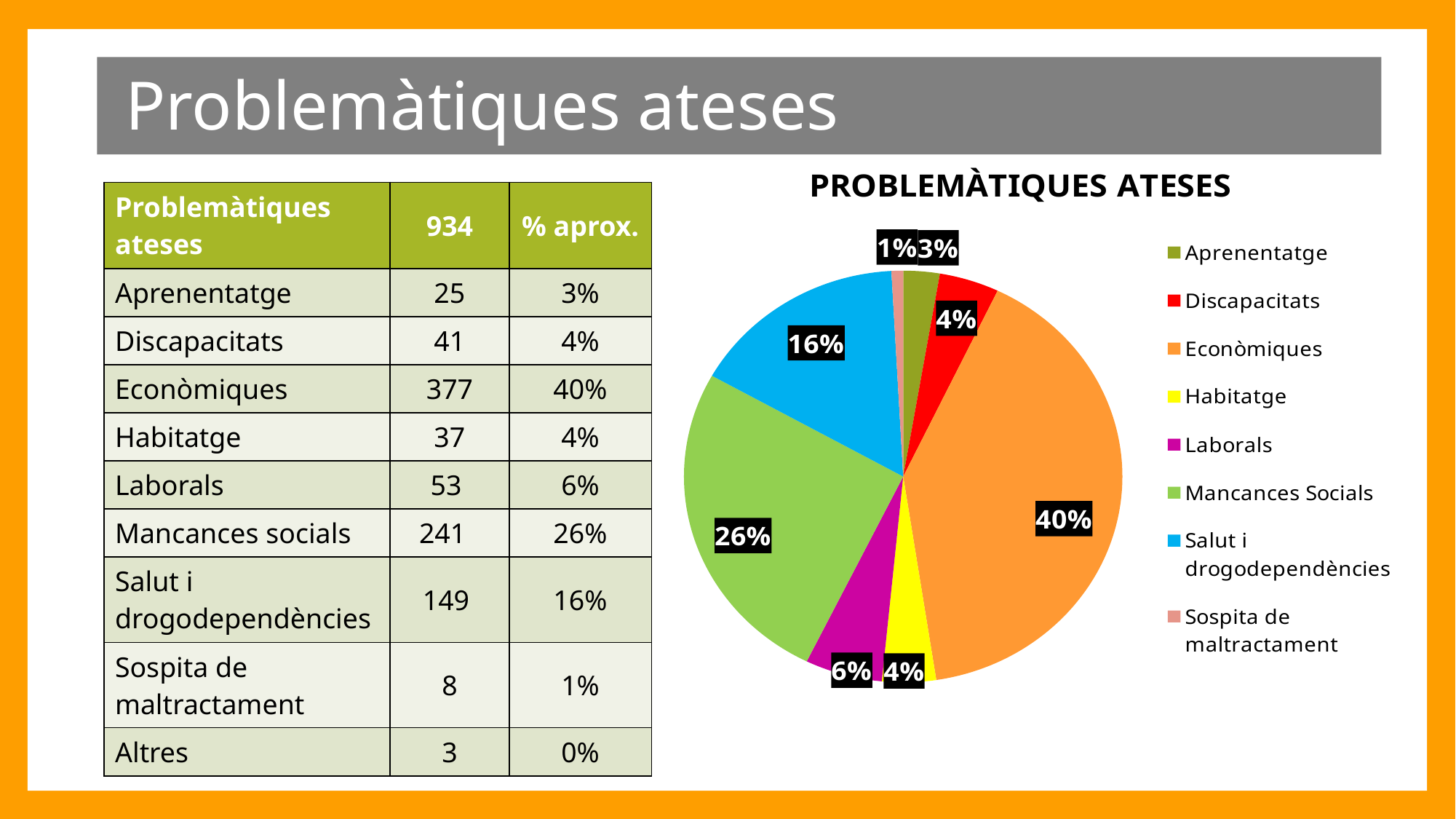
Which category has the smallest slice of the pie? Sospita de maltractament What is the difference in percentage points between the Econòmiques slice and the Mancances Socials slice? 14 What share of the pie does Mancances Socials represent? 26% Which slice is larger, Salut i drogodependències or Laborals? Salut i drogodependències What share of the pie does Aprenentatge represent? 3% What share of the pie does Salut i drogodependències represent? 16% How many categories does the pie chart's legend list? 8 Which category has the largest slice of the pie? Econòmiques What is the chart's title? PROBLEMÀTIQUES ATESES What type of chart is shown on the slide? pie chart